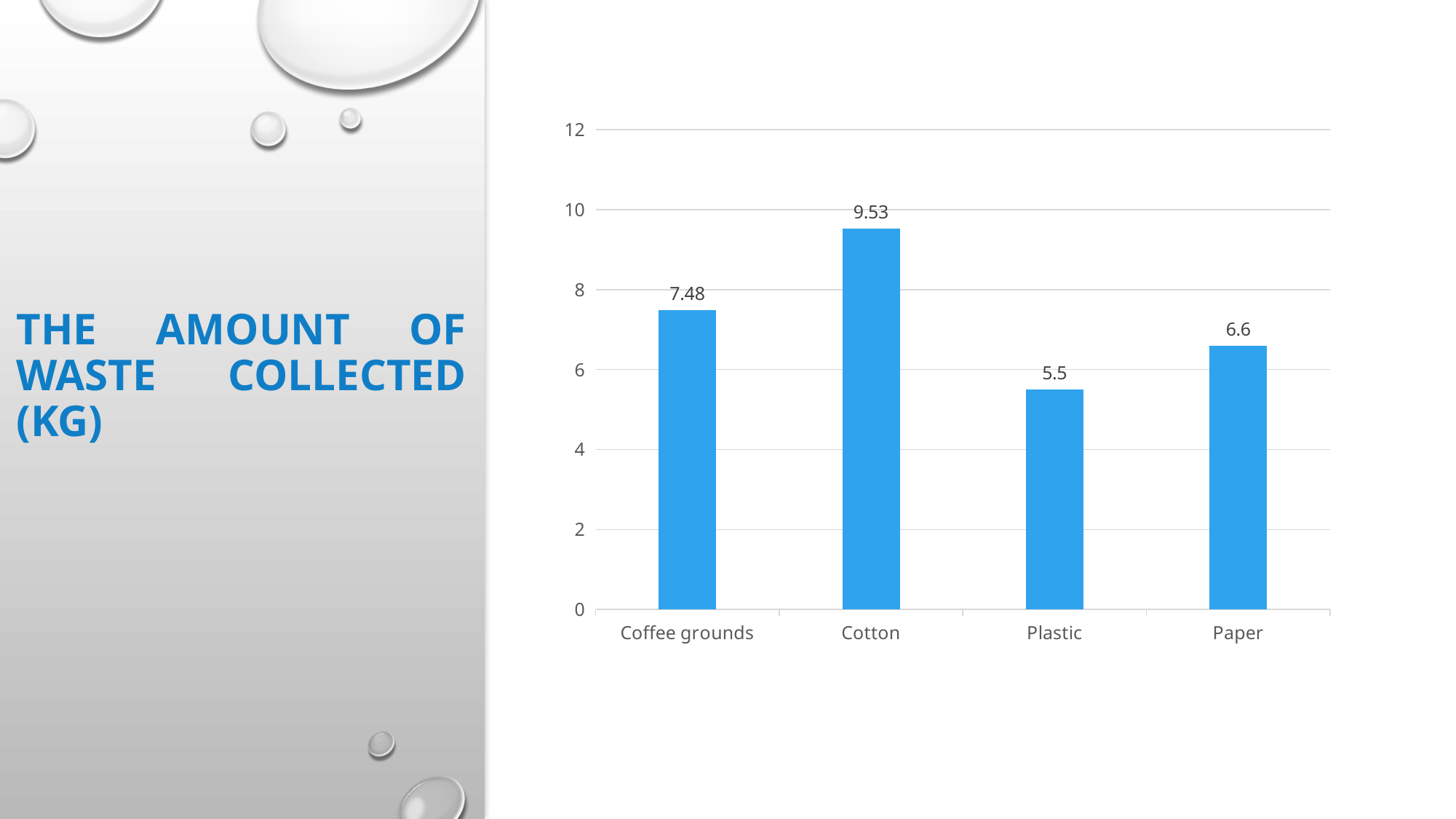
What is the amount of waste collected for Coffee grounds? 7.48 What is the amount of waste collected for Cotton? 9.53 Which category has the lowest amount of waste collected? Plastic Which is larger, the amount collected for Coffee grounds or for Paper? Coffee grounds What kind of chart is shown on the slide? Bar chart How many categories are shown on the chart? 4 What is the amount of waste collected for Plastic? 5.5 Which category has the highest amount of waste collected? Cotton What is the difference between the amounts collected for Coffee grounds and Paper? 0.88 What is the difference between the amounts collected for Cotton and Plastic? 4.03 What is the amount of waste collected for Paper? 6.6 Is the value for Cotton greater or less than 8? greater